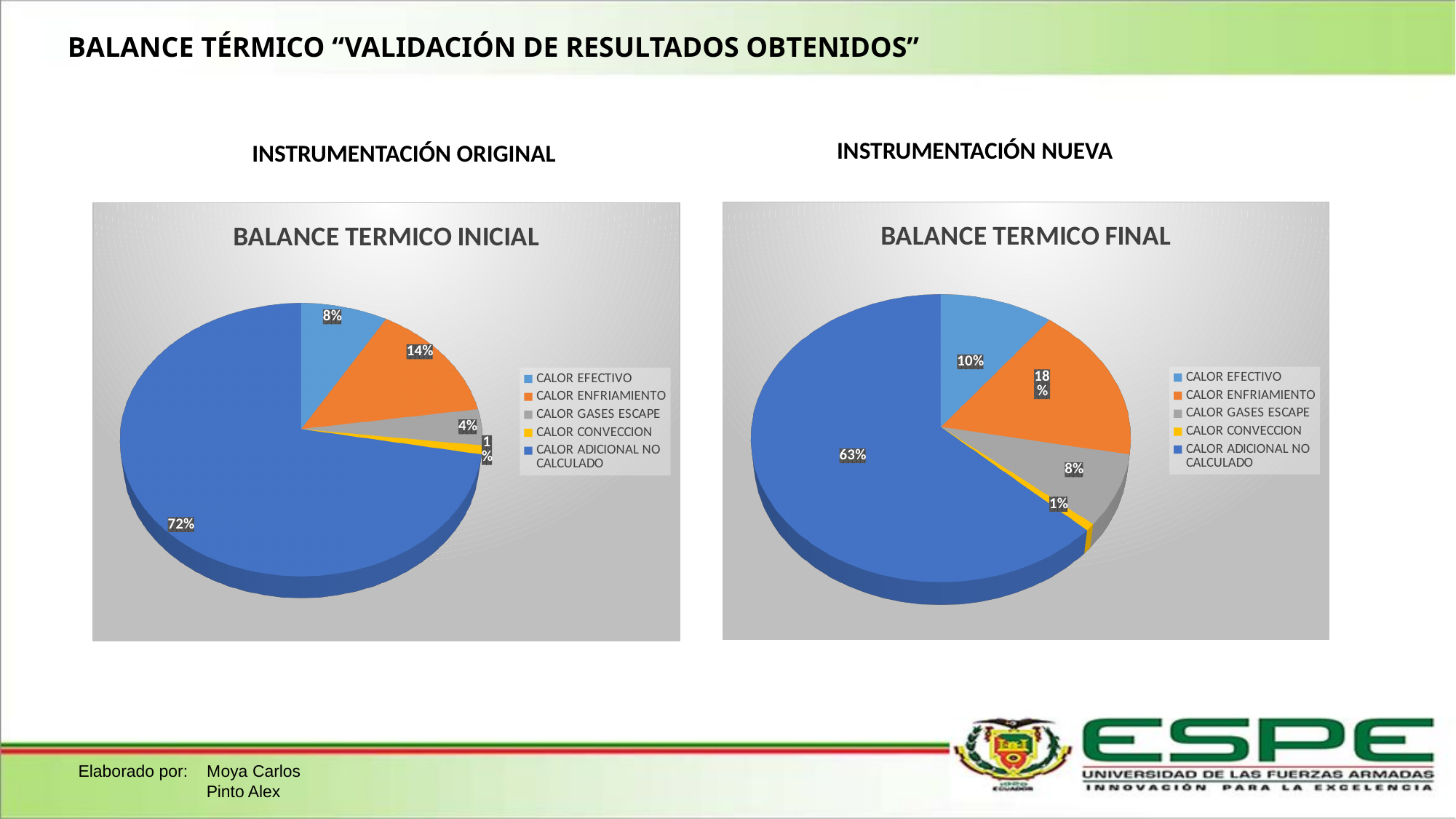
What kind of chart is the BALANCE TERMICO INICIAL chart? Pie chart In the BALANCE TERMICO FINAL chart, what is the value for CALOR GASES ESCAPE? 8% In the BALANCE TERMICO INICIAL chart, what is the value for CALOR ENFRIAMIENTO? 14% In the BALANCE TERMICO FINAL chart, which is larger, CALOR EFECTIVO or CALOR GASES ESCAPE? CALOR EFECTIVO In the BALANCE TERMICO FINAL chart, what is the value for CALOR ENFRIAMIENTO? 18% In the BALANCE TERMICO FINAL chart, what share does CALOR ADICIONAL NO CALCULADO have? 63% In the BALANCE TERMICO INICIAL chart, what is the difference between CALOR ENFRIAMIENTO and CALOR EFECTIVO? 6% In the BALANCE TERMICO FINAL chart, which category has the largest slice? CALOR ADICIONAL NO CALCULADO In the BALANCE TERMICO INICIAL chart, which category has the smallest slice? CALOR CONVECCION In the BALANCE TERMICO INICIAL chart, what is the value for CALOR EFECTIVO? 8% In the BALANCE TERMICO INICIAL chart, what share does CALOR ADICIONAL NO CALCULADO have? 72% How many categories does the legend of the BALANCE TERMICO FINAL chart list? 5